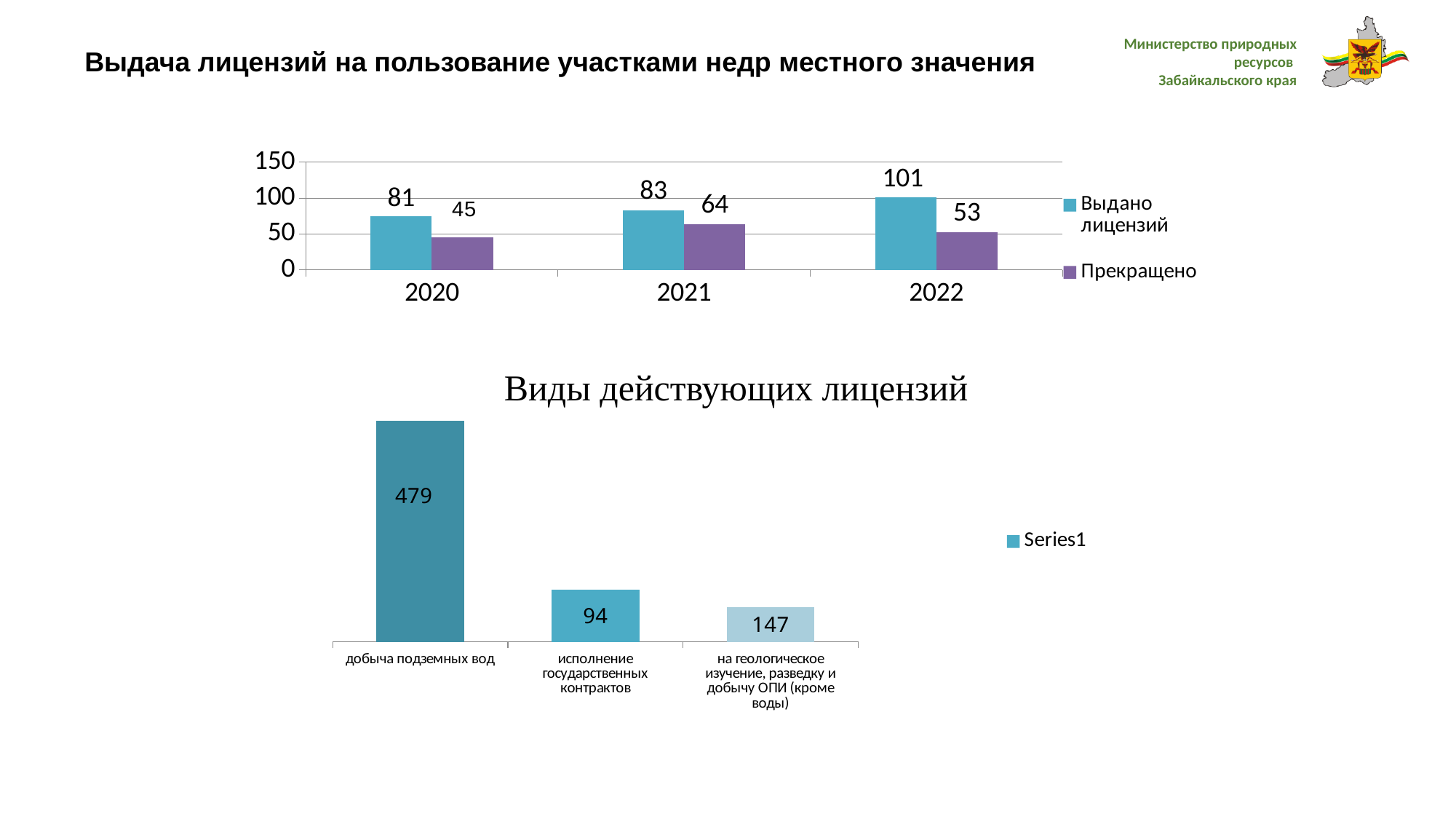
In the top chart, what is the value of Выдано лицензий for 2021? 83 In the top chart, what is the difference between Выдано лицензий and Прекращено in 2022? 48 In the chart titled Виды действующих лицензий, what is the value for исполнение государственных контрактов? 94 In the top chart, does the value of Выдано лицензий rise or fall from 2020 to 2022? rise In the chart titled Виды действующих лицензий, how many categories are shown? 3 What type of chart is the chart titled Виды действующих лицензий? bar chart In the top chart, which year has the highest value for Выдано лицензий? 2022 In the top chart, is the value of Прекращено for 2021 larger or smaller than for 2022? larger In the top chart, what is the value of Прекращено for 2020? 45 In the top chart, how many series does the legend list? 2 In the top chart, which year has the lowest value for Прекращено? 2020 In the chart titled Виды действующих лицензий, what is the value for добыча подземных вод? 479